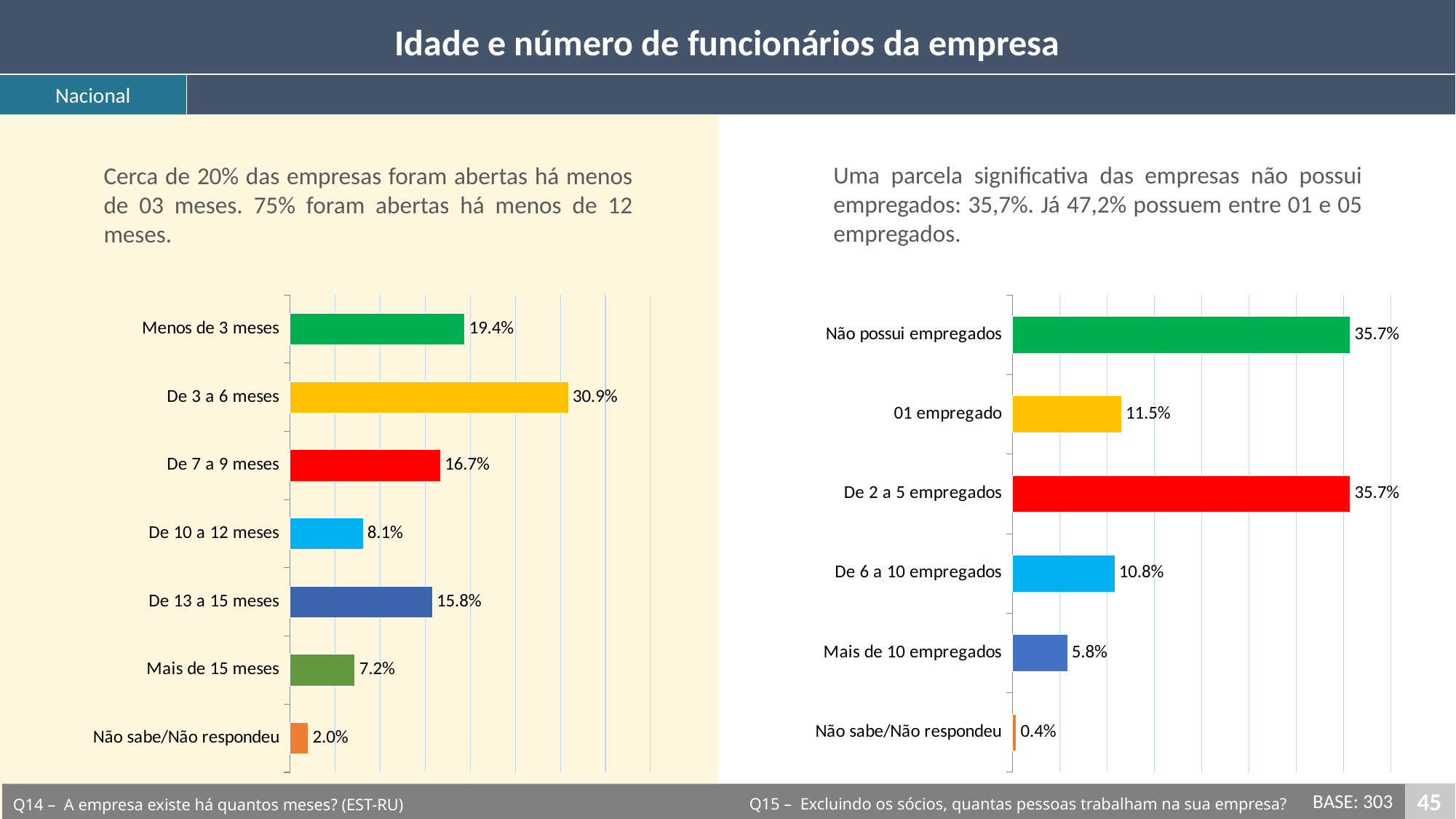
In the right chart, what is the value for Não possui empregados? 35.7% In the right chart, how many categories are shown? 6 In the left chart, what is the difference between De 3 a 6 meses and Menos de 3 meses? 11.5% In the left chart, what is the value for De 3 a 6 meses? 30.9% In the left chart, what is the value for De 13 a 15 meses? 15.8% In the left chart, how many categories are shown? 7 What type of chart is the right chart? Bar chart In the left chart, which category has the highest value? De 3 a 6 meses In the right chart, which is larger: 01 empregado or Mais de 10 empregados? 01 empregado In the right chart, what is the value for De 6 a 10 empregados? 10.8% In the left chart, which category has the lowest value? Não sabe/Não respondeu In the right chart, which category has the lowest value? Não sabe/Não respondeu